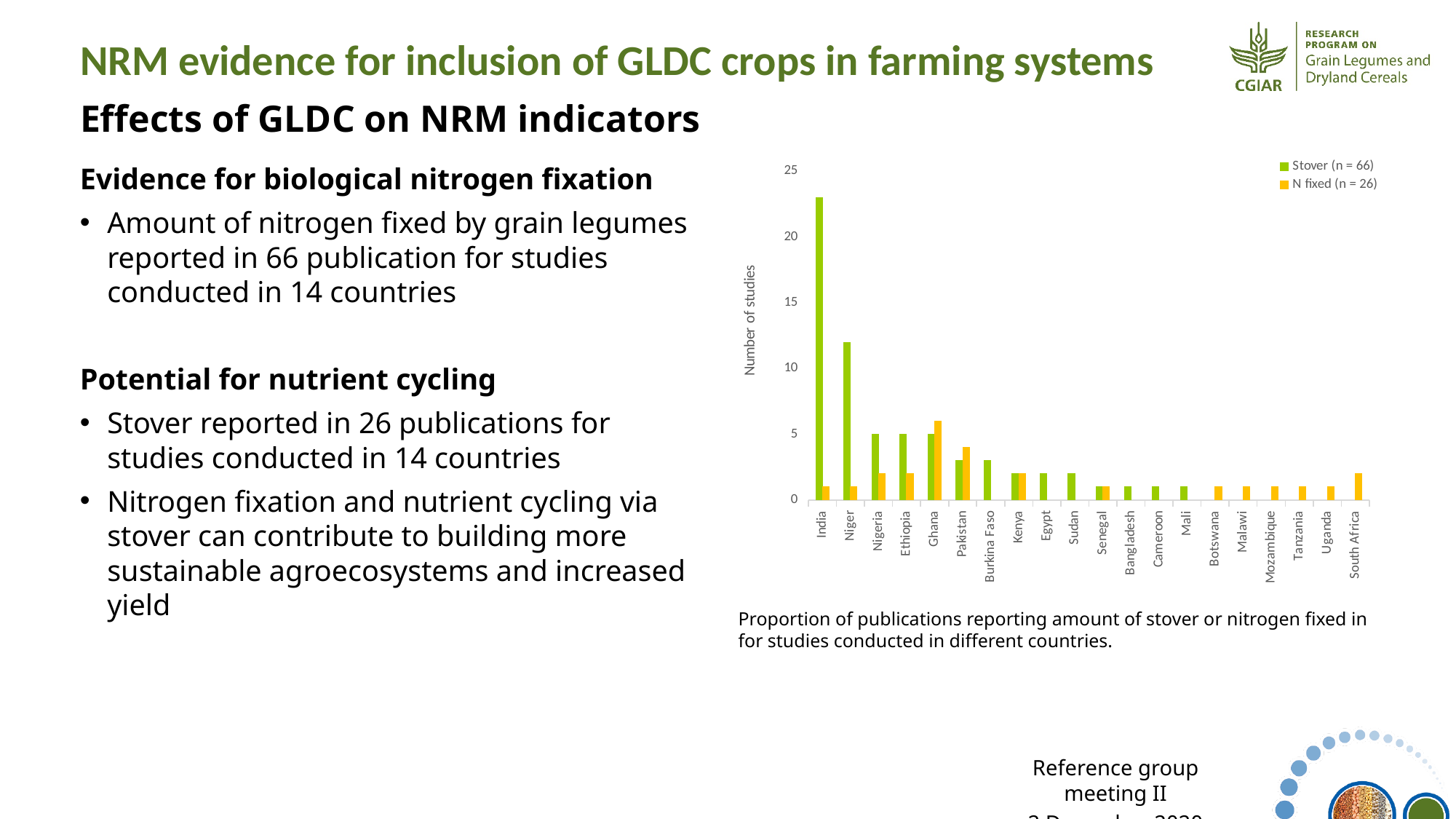
What is the label on the vertical axis of the chart? Number of studies Which is larger, the Stover value for India or the Stover value for Niger? India What are the two series named in the chart legend? Stover (n = 66) and N fixed (n = 26) What type of chart is shown on the slide? bar chart Is the Stover value for Niger greater or less than 10? greater Which country has the highest number of studies for the N fixed series? Ghana Do the Stover values generally rise or fall moving from left to right along the x axis? fall How many countries are shown on the x axis of the chart? 20 Which country has the highest number of studies for the Stover series? India Is the N fixed value for Ghana greater or less than 5? greater Is the Stover value for India greater or less than 20? greater How many series does the chart legend list? 2